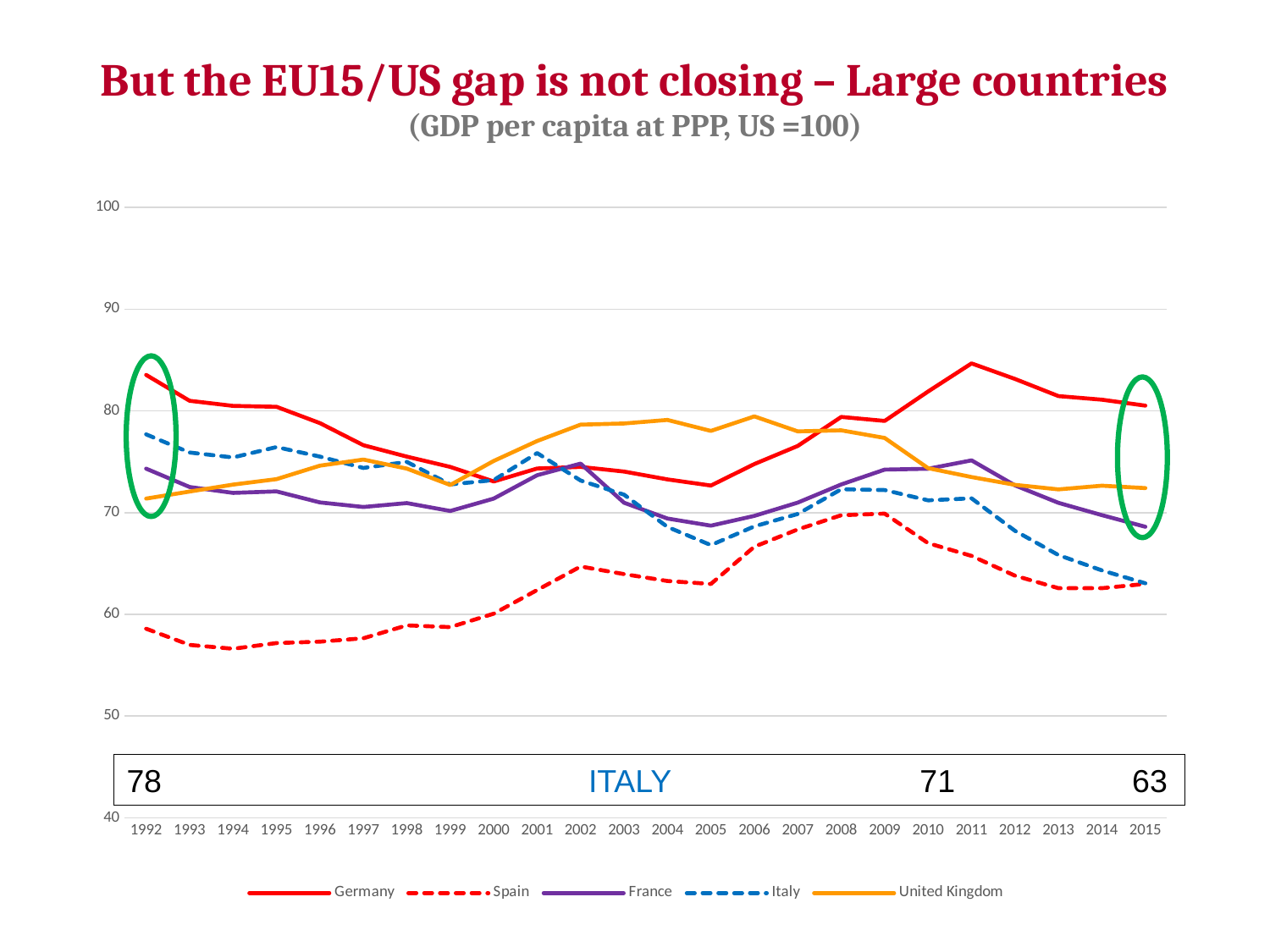
Which country has the highest value in 2011? Germany How many series does the legend list? 5 Is the value for Germany in 1992 greater or less than 80? greater Is the value for France in 2015 greater or less than 70? less Which country is named in the annotation box at the bottom of the chart? Italy Does the Germany line rise or fall between 2011 and 2015? fall What kind of chart is shown on the slide? line chart In 2015, which is larger, the value for Germany or the value for Spain? Germany Is the value for the United Kingdom in 2015 greater or less than 70? greater How many years are shown along the x axis? 24 Which country has the lowest value in 1992? Spain